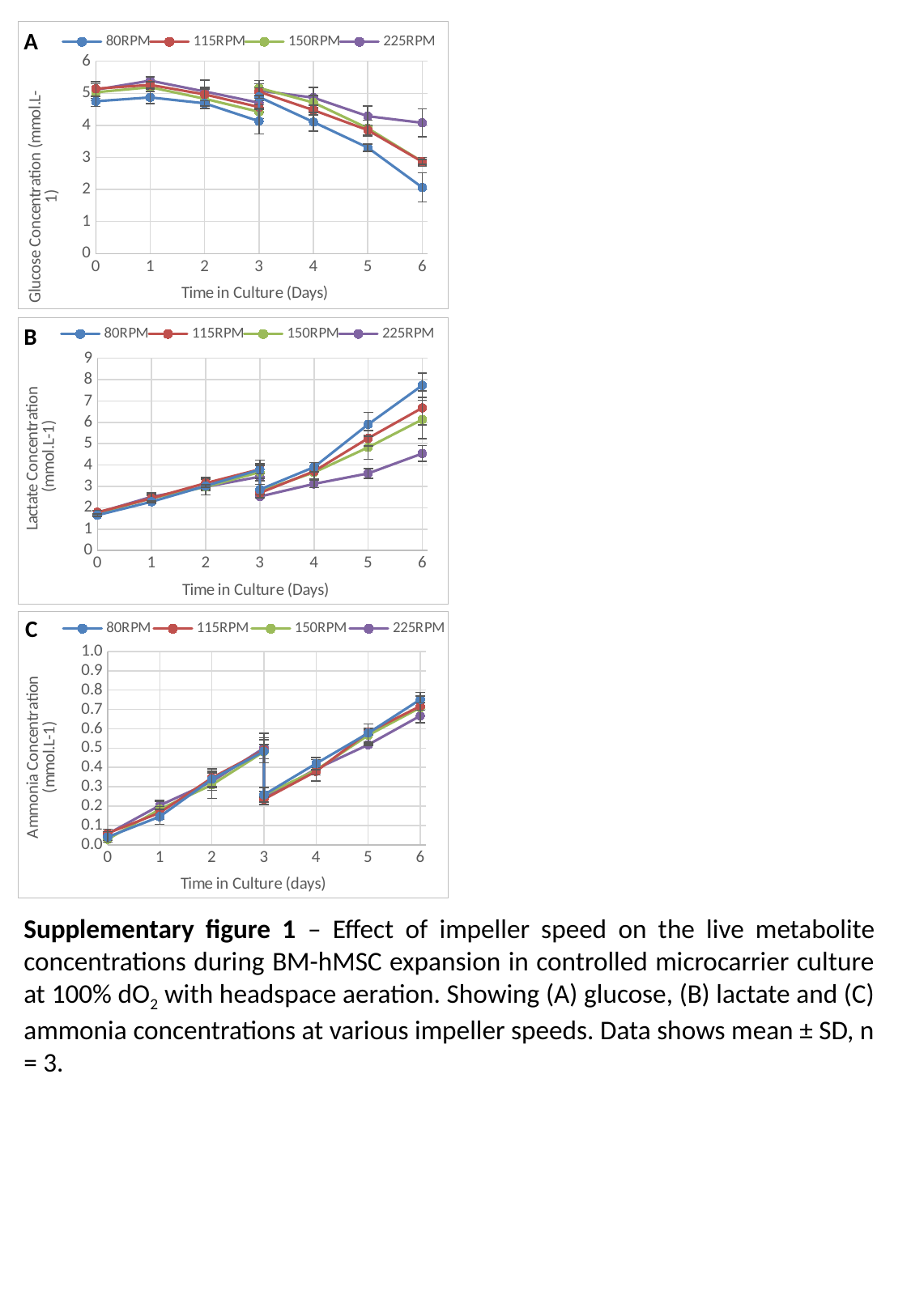
How many series does the legend of chart B (Lactate Concentration) list? 4 What is the x-axis title of chart B (Lactate Concentration)? Time in Culture (Days) In chart B (Lactate Concentration), is the value for 80RPM at day 6 greater or less than 7? greater In chart A (Glucose Concentration), do the values for 80RPM rise or fall from day 1 to day 6? fall How many time points (days) are plotted along the x axis of chart C (Ammonia Concentration)? 7 In chart A (Glucose Concentration), which series has the highest value at day 6? 225RPM In chart A (Glucose Concentration), which series has the lowest value at day 6? 80RPM In chart B (Lactate Concentration), which series has the lowest value at day 6? 225RPM In chart B (Lactate Concentration), do the values for 80RPM rise or fall from day 0 to day 6? rise What kind of chart is chart A (Glucose Concentration)? line chart In chart A (Glucose Concentration), is the value for 80RPM at day 6 greater or less than 3? less In chart C (Ammonia Concentration), which is larger at day 6: the value for 80RPM or the value for 225RPM? 80RPM